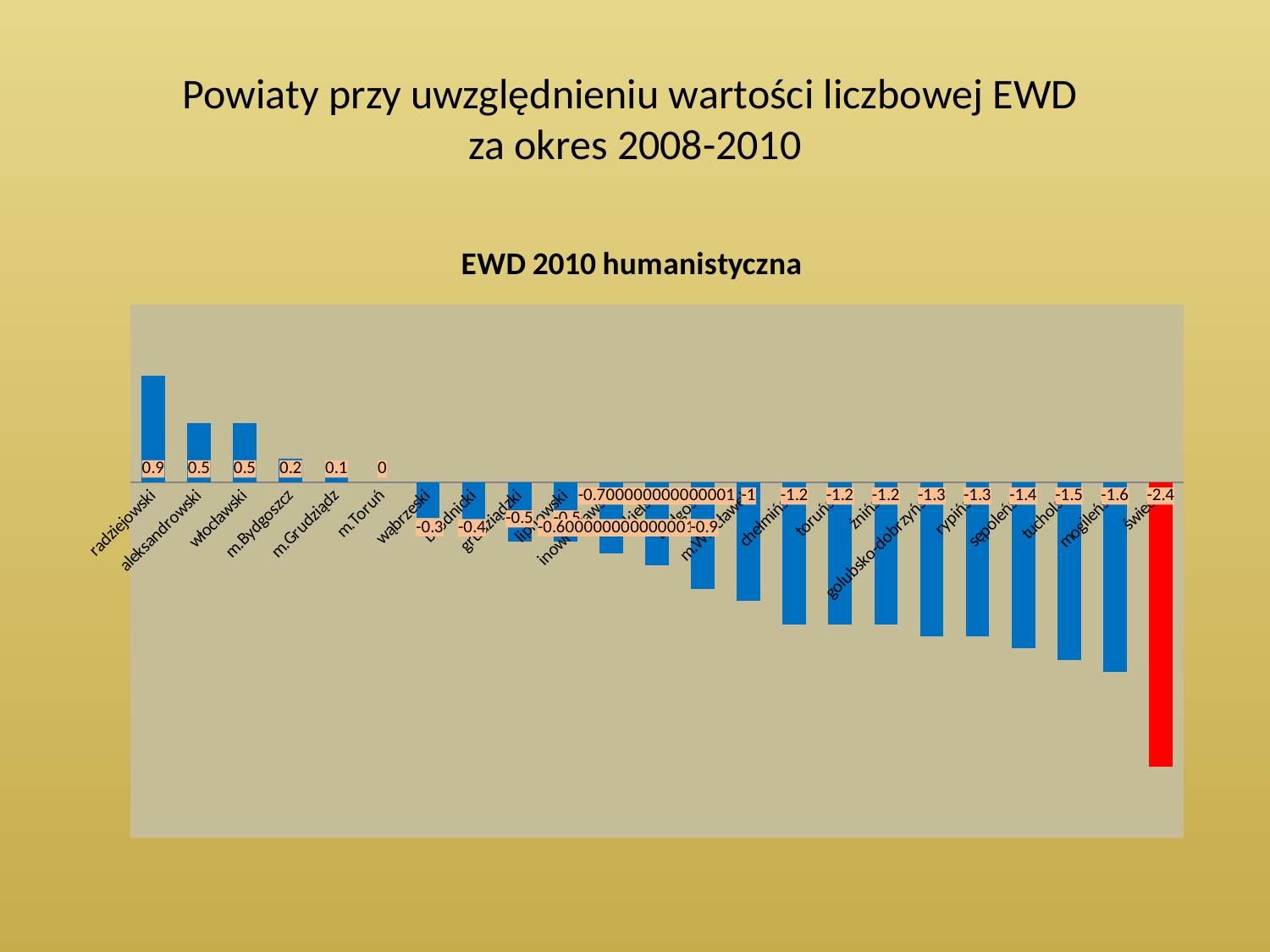
Do the values rise or fall from left to right along the x axis? Fall What is the value of the red bar, the lowest in the EWD 2010 humanistyczna chart? -2.4 What is the value for tucholski in the EWD 2010 humanistyczna chart? -1.5 What is the difference between the values for radziejowski and aleksandrowski? 0.4 What kind of chart is shown on the slide? Bar chart Which has the larger value, m.Bydgoszcz or m.Grudziądz? m.Bydgoszcz What is the title of the chart? EWD 2010 humanistyczna What is the value for mogileński in the EWD 2010 humanistyczna chart? -1.6 What is the value for radziejowski in the EWD 2010 humanistyczna chart? 0.9 What is the value for m.Toruń in the EWD 2010 humanistyczna chart? 0 What is the value for chełmiński in the EWD 2010 humanistyczna chart? -1.2 Which powiat has the highest value in the EWD 2010 humanistyczna chart? radziejowski